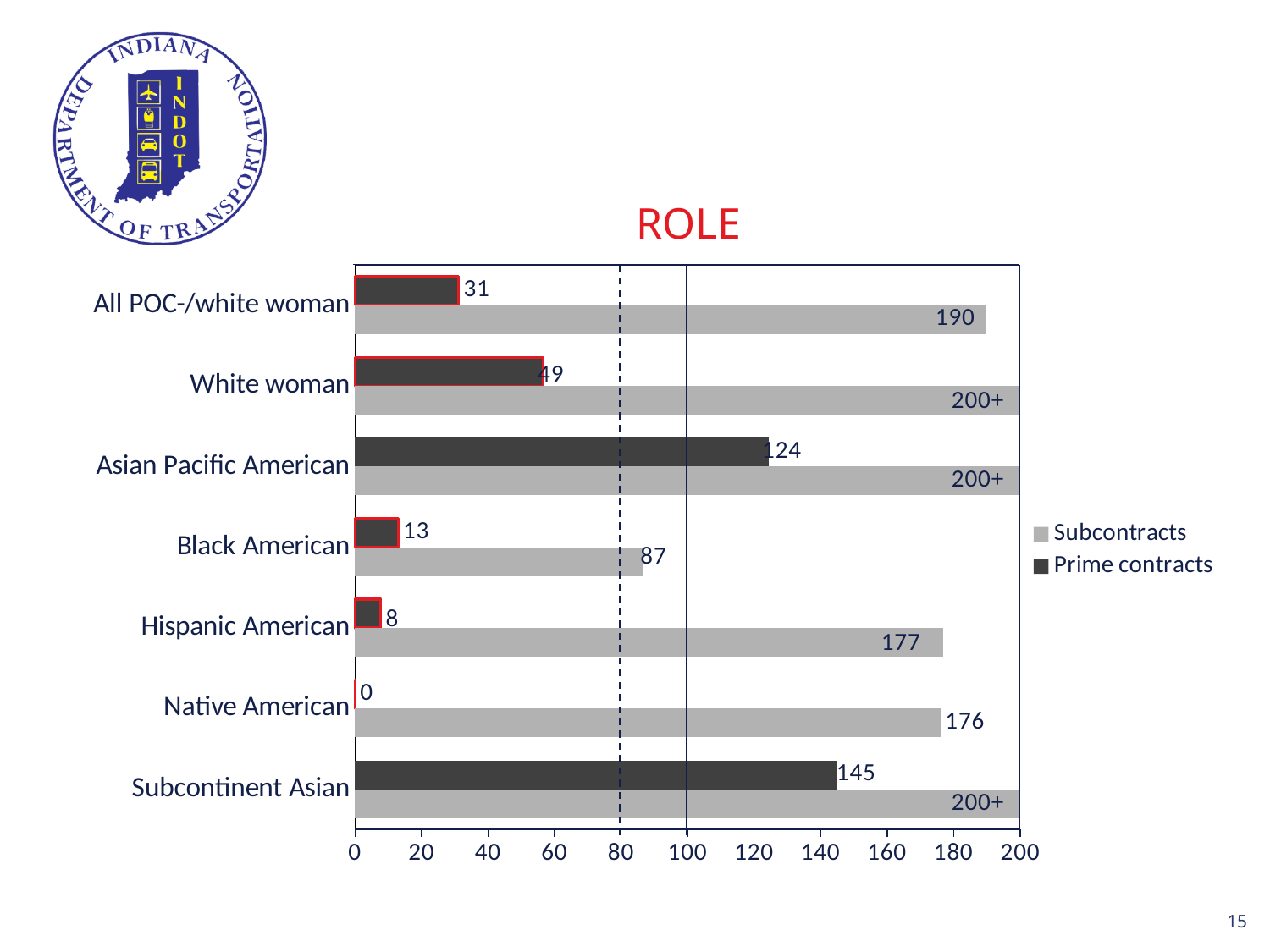
What is the Prime contracts value for Asian Pacific American? 124 Which category has the highest Prime contracts value? Subcontinent Asian Is the Subcontracts value for Native American greater or less than 160? greater What is the Subcontracts value for All POC-/white woman? 190 Which category has the lowest Subcontracts value? Black American What is the difference between the Subcontracts and Prime contracts values for Black American? 74 What is the Subcontracts value for Hispanic American? 177 How many series does the legend list? 2 Which is larger: the Prime contracts value for White woman or for All POC-/white woman? White woman What kind of chart is shown on the slide? Bar chart How many categories are shown on the chart? 7 What is the Prime contracts value for Native American? 0